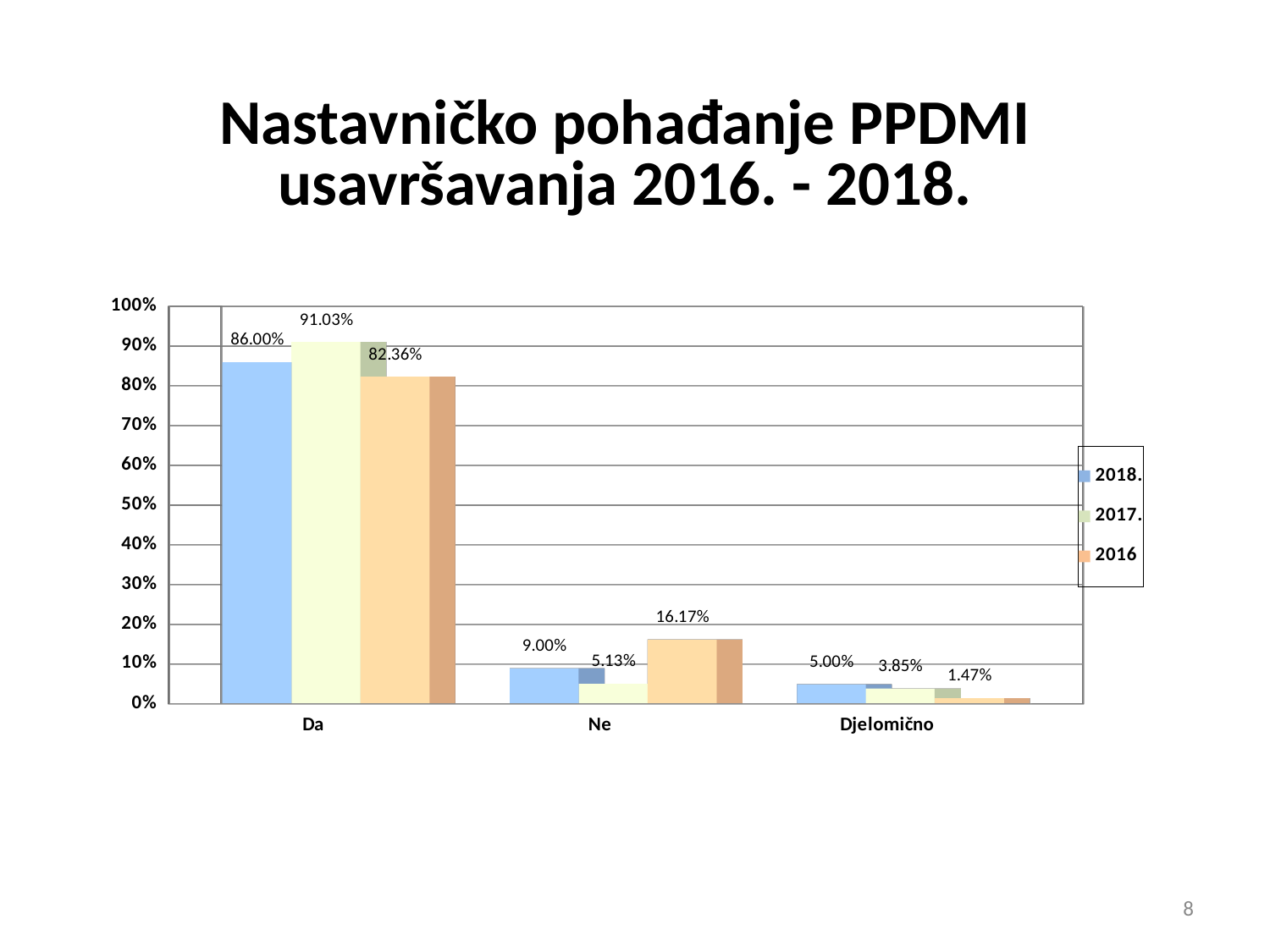
What is the value for 2017. in the Da category? 91.03% Is the value for 2016 in the Da category greater or less than 90%? less Which is larger in the Ne category, the value for 2018. or the value for 2017.? 2018. What is the value for 2018. in the Da category? 86.00% How many categories are shown on the x axis? 3 What is the value for 2016 in the Djelomično category? 1.47% What is the value for 2016 in the Ne category? 16.17% What is the difference between the 2017. and 2016 values in the Da category? 8.67% How many series does the legend list? 3 Which year has the lowest value in the Djelomično category? 2016 Which year has the highest value in the Da category? 2017. What kind of chart is shown on the slide? bar chart